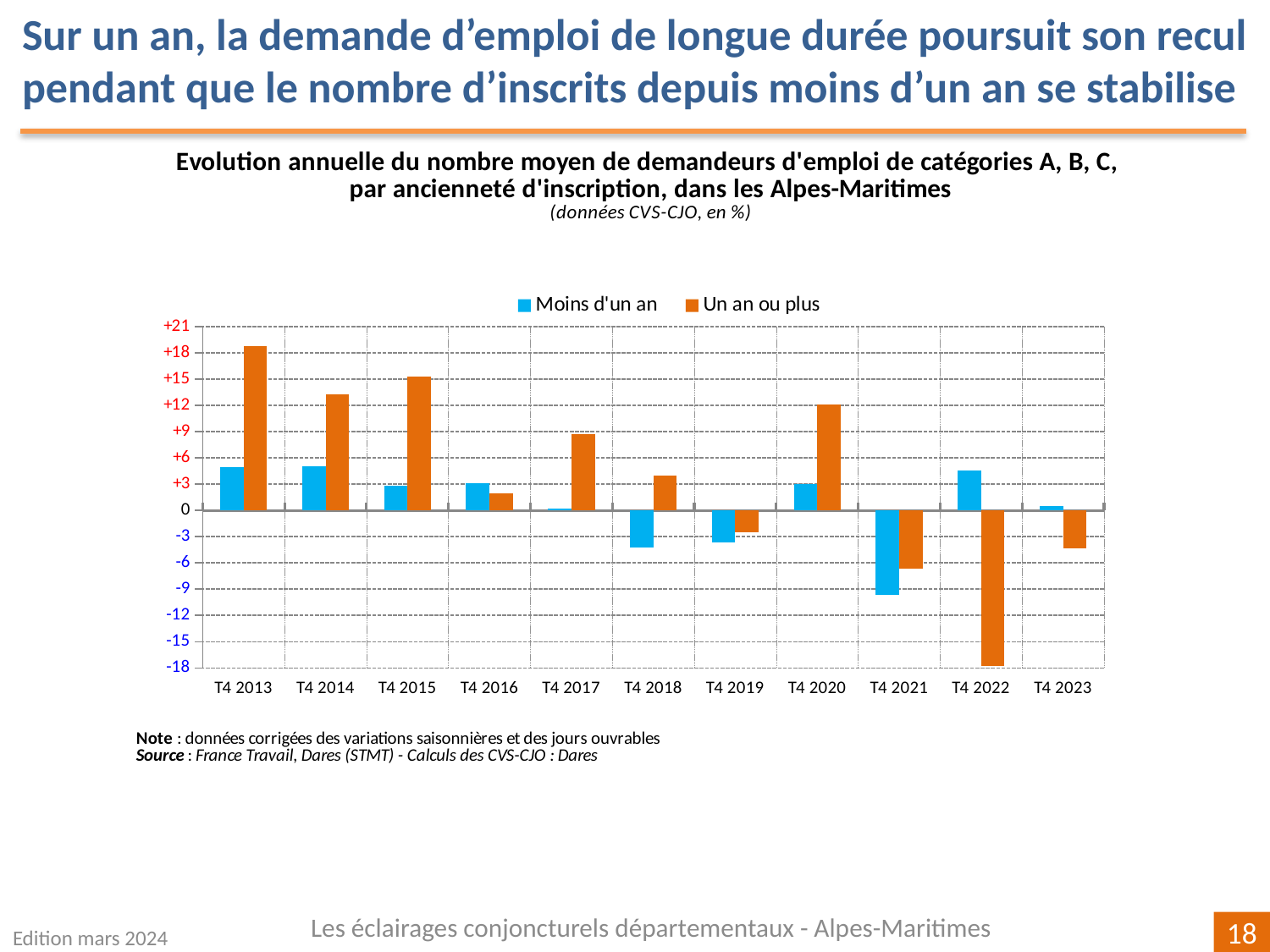
Is the value for 'Moins d'un an' in T4 2021 greater or less than -6? less In T4 2020, which series has the larger value, 'Moins d'un an' or 'Un an ou plus'? Un an ou plus For the series 'Un an ou plus', which quarter has the lowest value? T4 2022 Is the value for 'Un an ou plus' in T4 2013 greater or less than +15? greater What colour represents the series 'Moins d'un an'? blue For the series 'Un an ou plus', which is larger, the value in T4 2014 or in T4 2015? T4 2015 Is the value for 'Un an ou plus' in T4 2022 greater or less than -15? less For the series 'Moins d'un an', which quarter has the lowest value? T4 2021 How many quarters (categories) are shown on the x axis? 11 For the series 'Un an ou plus', which quarter has the highest value? T4 2013 What kind of chart is shown on the slide? bar chart How many series does the legend list? 2